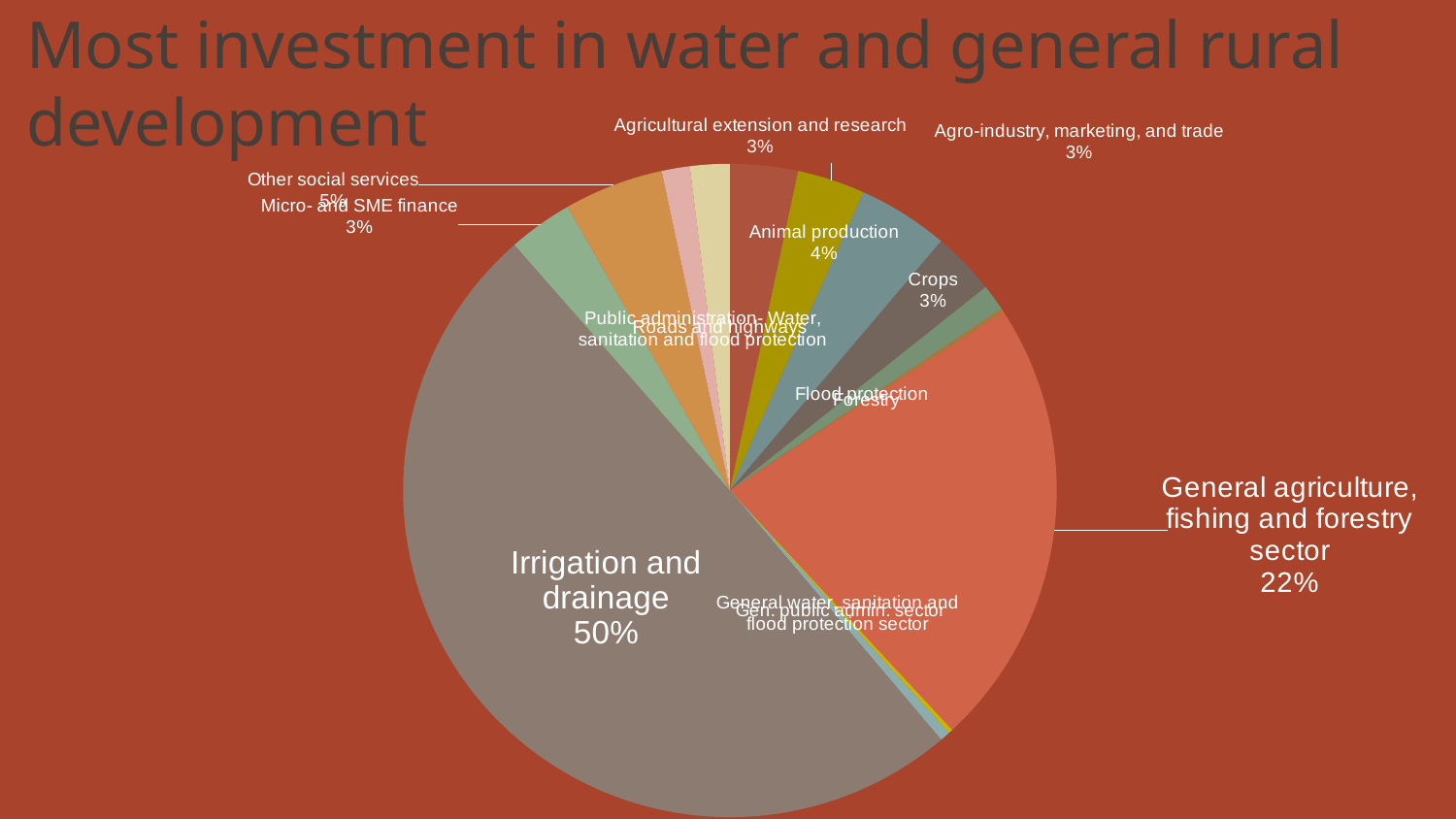
What kind of chart is shown on the slide? pie chart What share of the pie does Animal production have? 4% Which slice is larger: Irrigation and drainage or General agriculture, fishing and forestry sector? Irrigation and drainage What share of the pie does the General agriculture, fishing and forestry sector have? 22% Which category has the largest slice of the pie? Irrigation and drainage What share of the pie does Agricultural extension and research have? 3% By how many percentage points does Irrigation and drainage exceed the General agriculture, fishing and forestry sector? 28 percentage points What share of the pie does Irrigation and drainage have? 50% What share of the pie does Other social services have? 5% What is the title of the slide? Most investment in water and general rural development What share of the pie does Micro- and SME finance have? 3% What share of the pie does Crops have? 3%